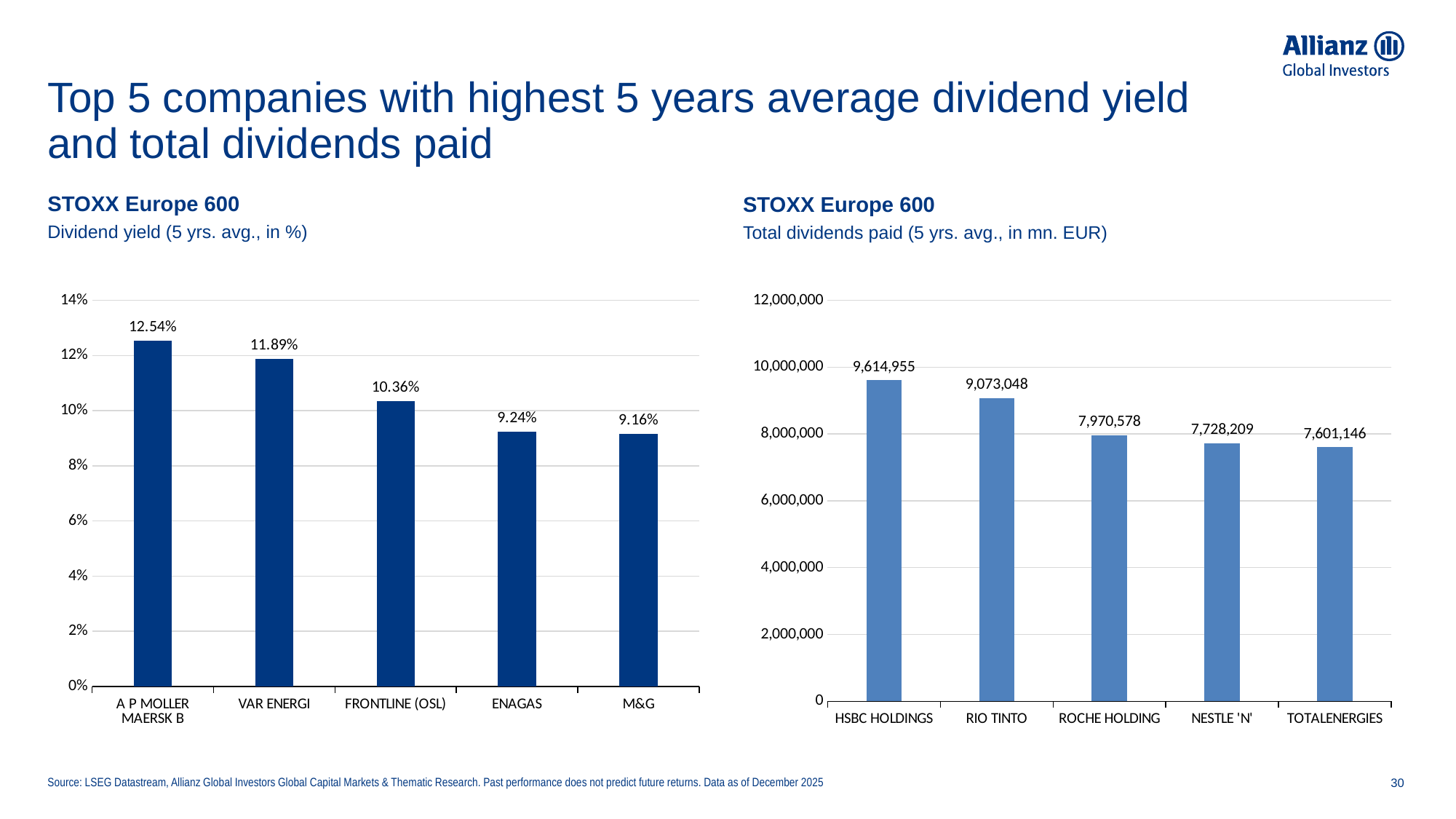
In the right chart (Total dividends paid), which company has the highest total dividends paid? HSBC HOLDINGS In the left chart (Dividend yield), what is the difference between the values for A P MOLLER MAERSK B and FRONTLINE (OSL)? 2.18% In the left chart (Dividend yield), is the value for ENAGAS greater or less than 10%? less In the right chart (Total dividends paid), what is the difference between the values for HSBC HOLDINGS and RIO TINTO? 541,907 In the right chart (Total dividends paid), which is larger, the value for NESTLE 'N' or TOTALENERGIES? NESTLE 'N' In the right chart (Total dividends paid), what is the value for ROCHE HOLDING? 7,970,578 In the left chart (Dividend yield), how many companies are shown? 5 In the right chart (Total dividends paid), do the values rise or fall from left to right? fall In the left chart (Dividend yield), what is the value for VAR ENERGI? 11.89% In the left chart (Dividend yield), which company has the lowest dividend yield? M&G What kind of chart is the right chart (Total dividends paid)? bar chart In the left chart (Dividend yield), which company has the highest dividend yield? A P MOLLER MAERSK B